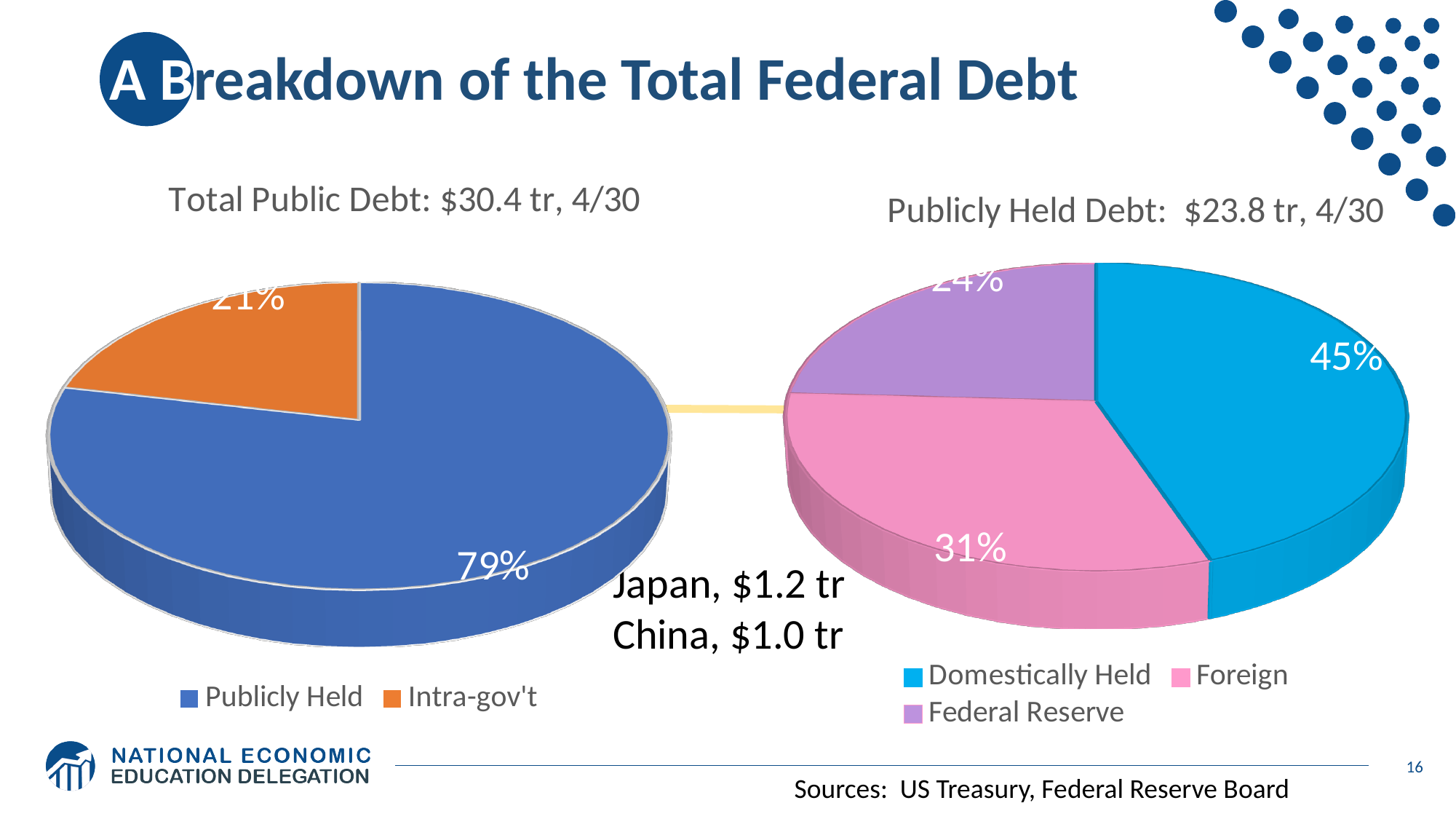
In the 'Publicly Held Debt' pie chart, what share is Domestically Held? 45% What total amount is stated in the title of the 'Publicly Held Debt' chart? $23.8 tr In the 'Publicly Held Debt' pie chart, which category has the largest share? Domestically Held In the 'Total Public Debt' pie chart, what is the difference in percentage points between Publicly Held and Intra-gov't? 58 In the 'Publicly Held Debt' pie chart, what share is Foreign? 31% In the 'Total Public Debt' pie chart, what share is Publicly Held? 79% In the 'Publicly Held Debt' pie chart, which is larger, Foreign or Federal Reserve? Foreign How many categories does the 'Publicly Held Debt' pie chart show? 3 In the 'Total Public Debt' pie chart, what share is Intra-gov't? 21% What type of chart is the 'Total Public Debt' chart? Pie chart In the 'Publicly Held Debt' pie chart, which category has the smallest share? Federal Reserve In the 'Publicly Held Debt' pie chart, what share is Federal Reserve? 24%